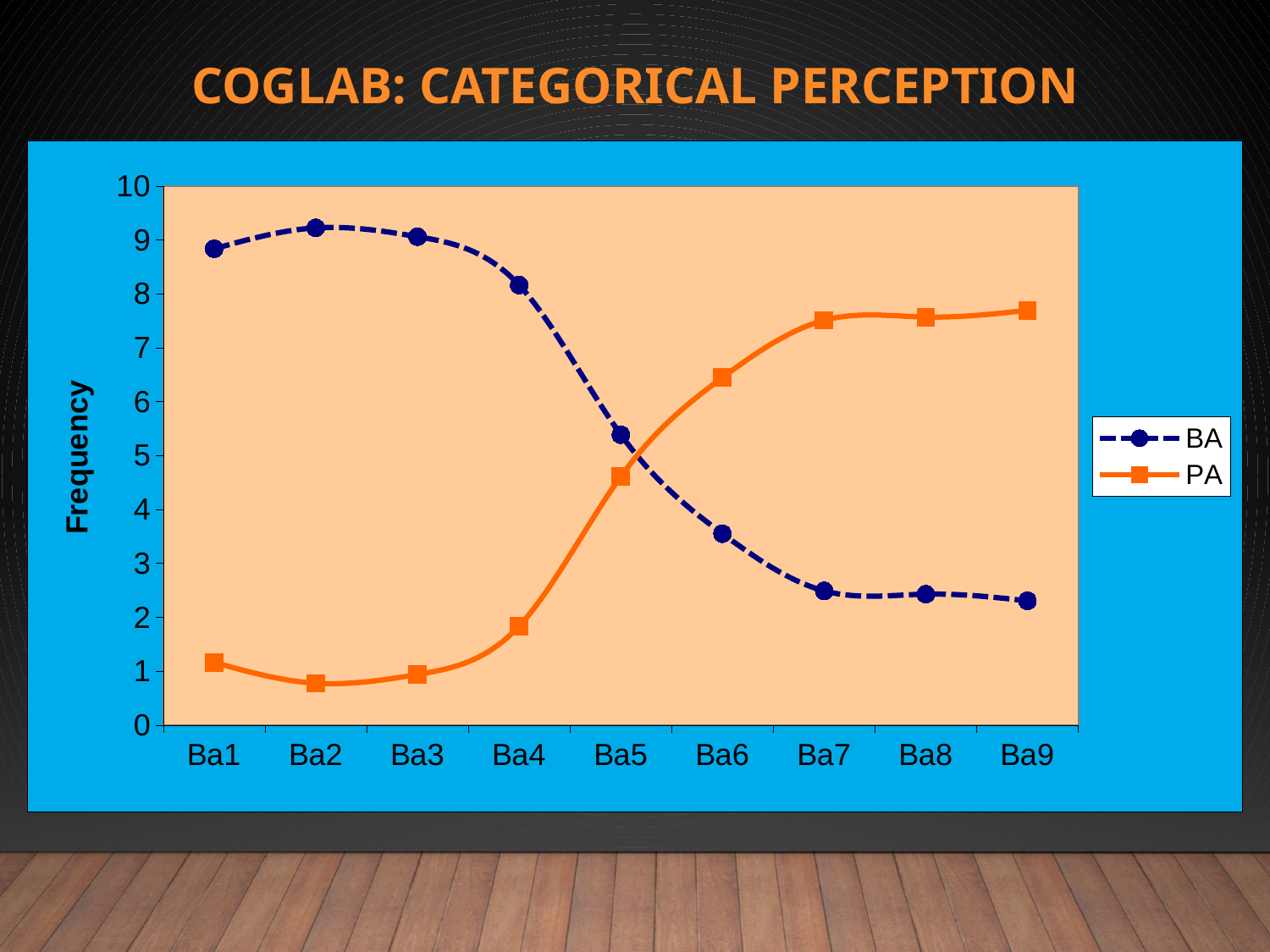
Which series is drawn with a dashed line? BA At Ba9, which series has the higher value, BA or PA? PA How many series does the legend list? 2 Is the BA value at Ba4 greater or less than 8? greater What kind of chart is shown on the slide? line chart Is the PA value at Ba6 greater or less than 6? greater Is the BA value at Ba7 greater or less than 3? less Does the PA series overall rise or fall from Ba1 to Ba9? rise How many categories are shown along the x axis? 9 What is the label of the y axis? Frequency At Ba1, which series has the higher value, BA or PA? BA